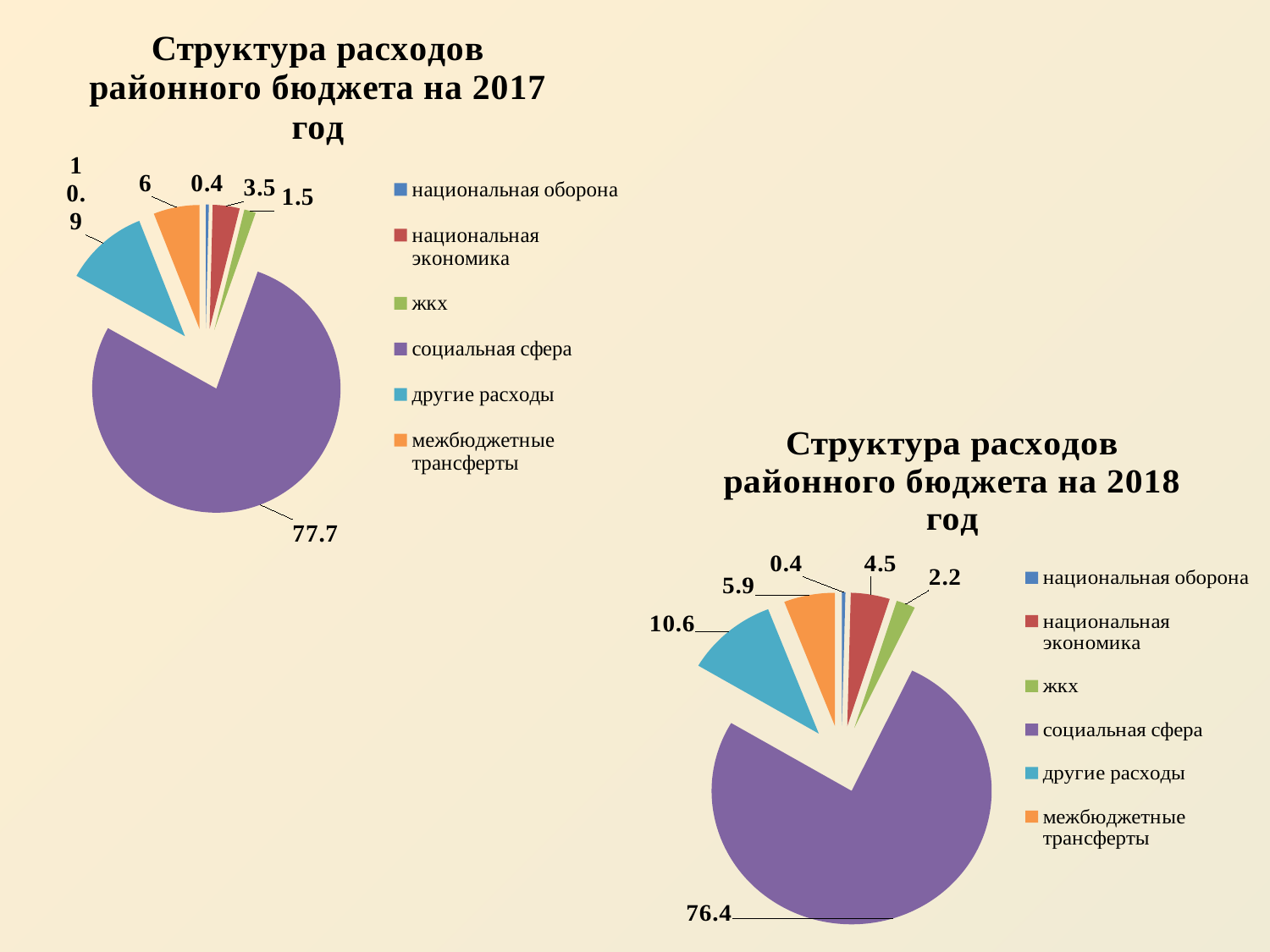
In the 2018 chart, what is the value for другие расходы? 10.6 In the 2017 chart, which is larger: межбюджетные трансферты or национальная экономика? межбюджетные трансферты In the 2017 chart, which category has the smallest slice? национальная оборона In the 2018 chart, what is the value for жкх? 2.2 In the 2017 chart, what is the value for социальная сфера? 77.7 In the 2017 chart, what is the value for национальная экономика? 3.5 In the 2017 chart, what colour is the slice for другие расходы? light blue What is the difference between the value for социальная сфера in the 2017 chart and in the 2018 chart? 1.3 In the 2018 chart, what is the difference between the values for социальная сфера and другие расходы? 65.8 What kind of chart is the 'Структура расходов районного бюджета на 2017 год' chart? pie chart In the 2018 chart, which category has the largest slice? социальная сфера How many categories does the legend of the 2018 chart list? 6